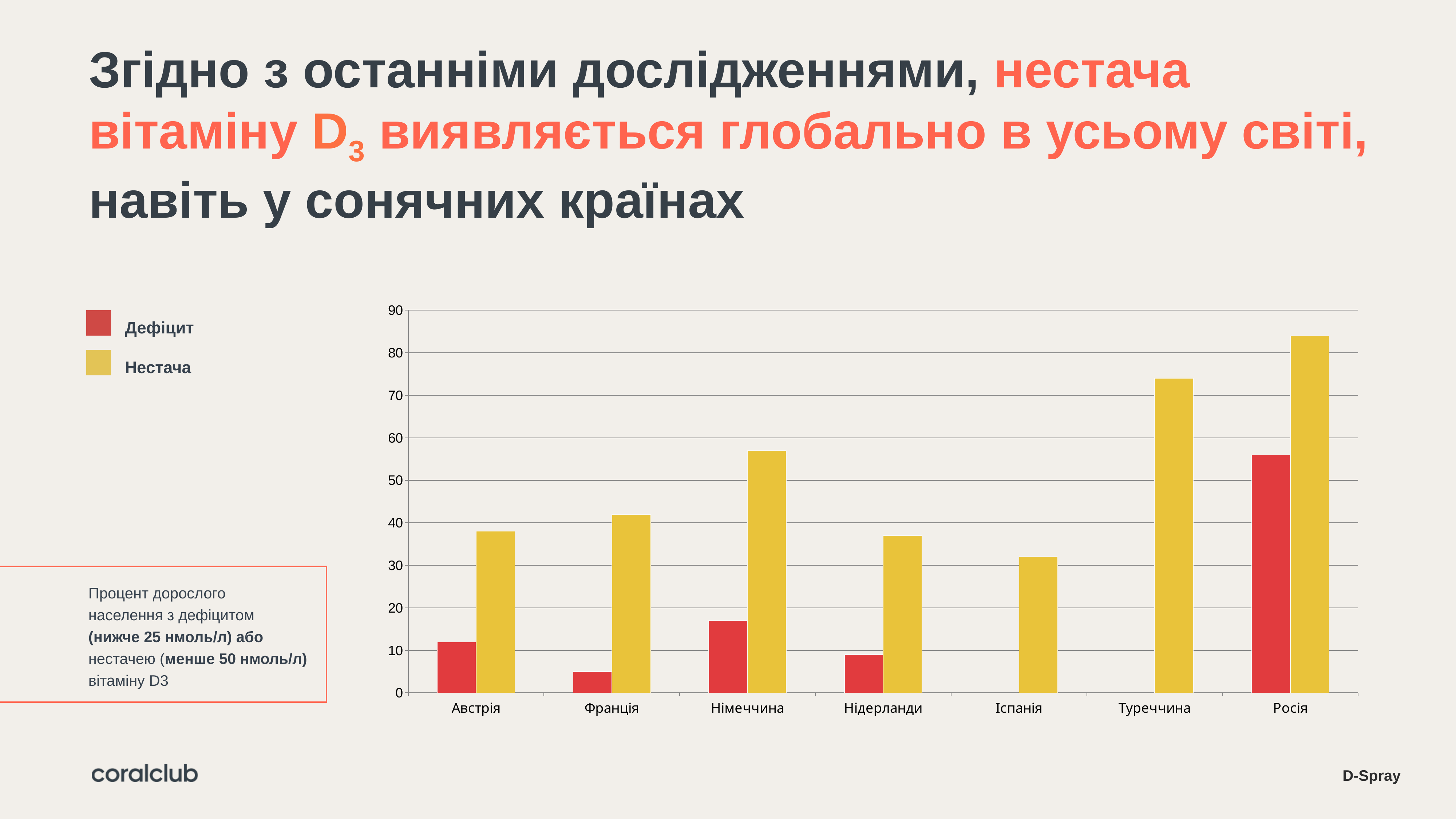
Is the Нестача value for Туреччина greater or less than 70? greater Which series is shown in red in the chart's legend? Дефіцит How many countries are shown on the x axis of the chart? 7 Which country has the highest value for Дефіцит? Росія Which is larger, the Нестача value for Німеччина or for Франція? Німеччина How many series does the chart's legend list? 2 Is the Дефіцит value for Франція greater or less than 10? less Is the Нестача value for Німеччина greater or less than 60? less What kind of chart is shown on the slide? bar chart Which country has the lowest value for Нестача? Іспанія Which country has the highest value for Нестача? Росія